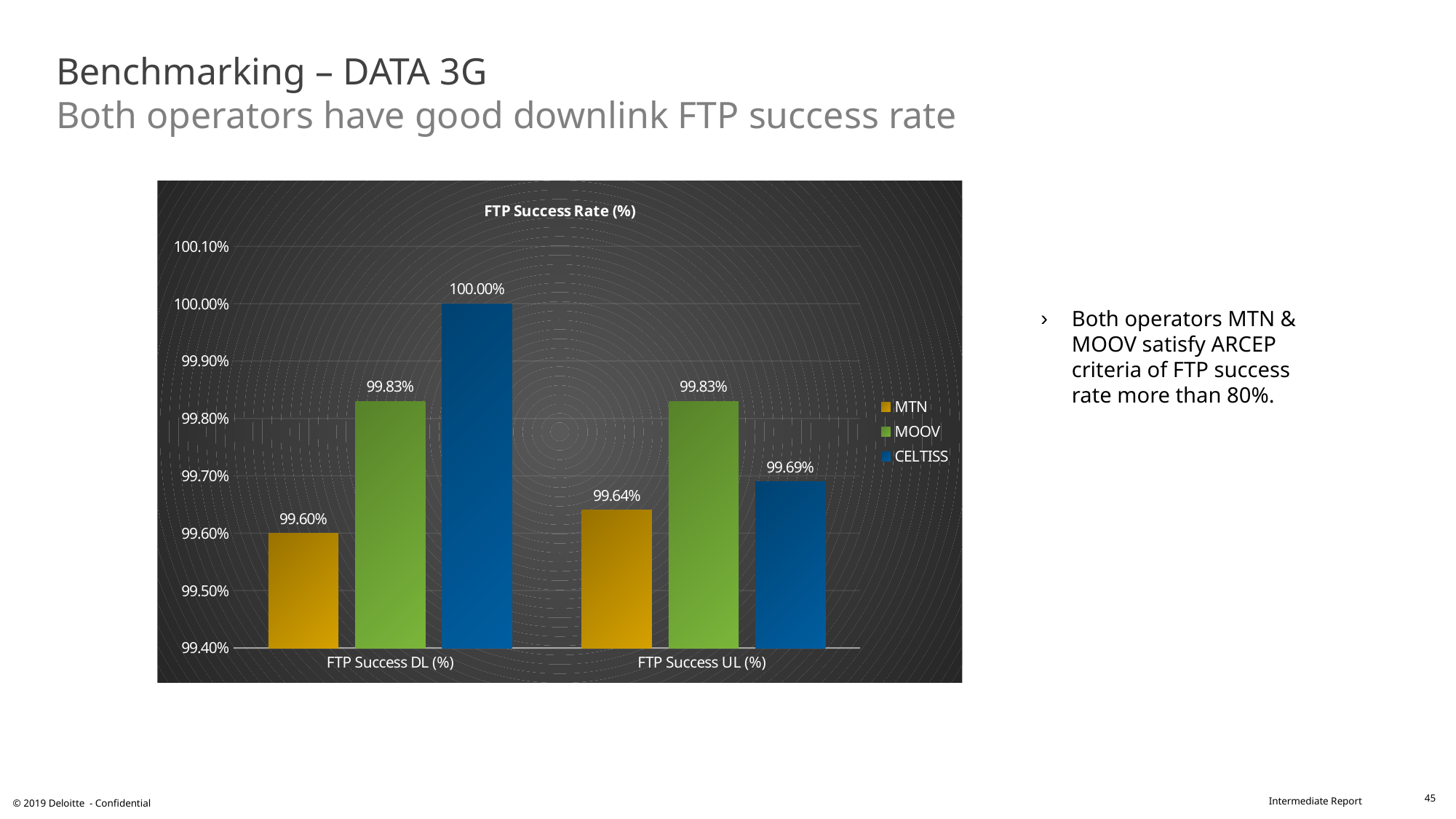
Which is larger: MOOV's FTP Success UL (%) or CELTISS's FTP Success UL (%)? MOOV's FTP Success UL (%) What kind of chart is shown on the slide? Bar chart What is the difference between CELTISS's FTP Success DL (%) and FTP Success UL (%)? 0.31% What is the FTP Success DL (%) value for MTN? 99.60% What is the title of the chart? FTP Success Rate (%) What is the FTP Success UL (%) value for MTN? 99.64% What is the FTP Success DL (%) value for CELTISS? 100.00% How many series does the legend list? 3 What is the FTP Success UL (%) value for CELTISS? 99.69% Which operator has the lowest FTP Success UL (%)? MTN How many categories are shown on the x axis? 2 Which operator has the highest FTP Success DL (%)? CELTISS